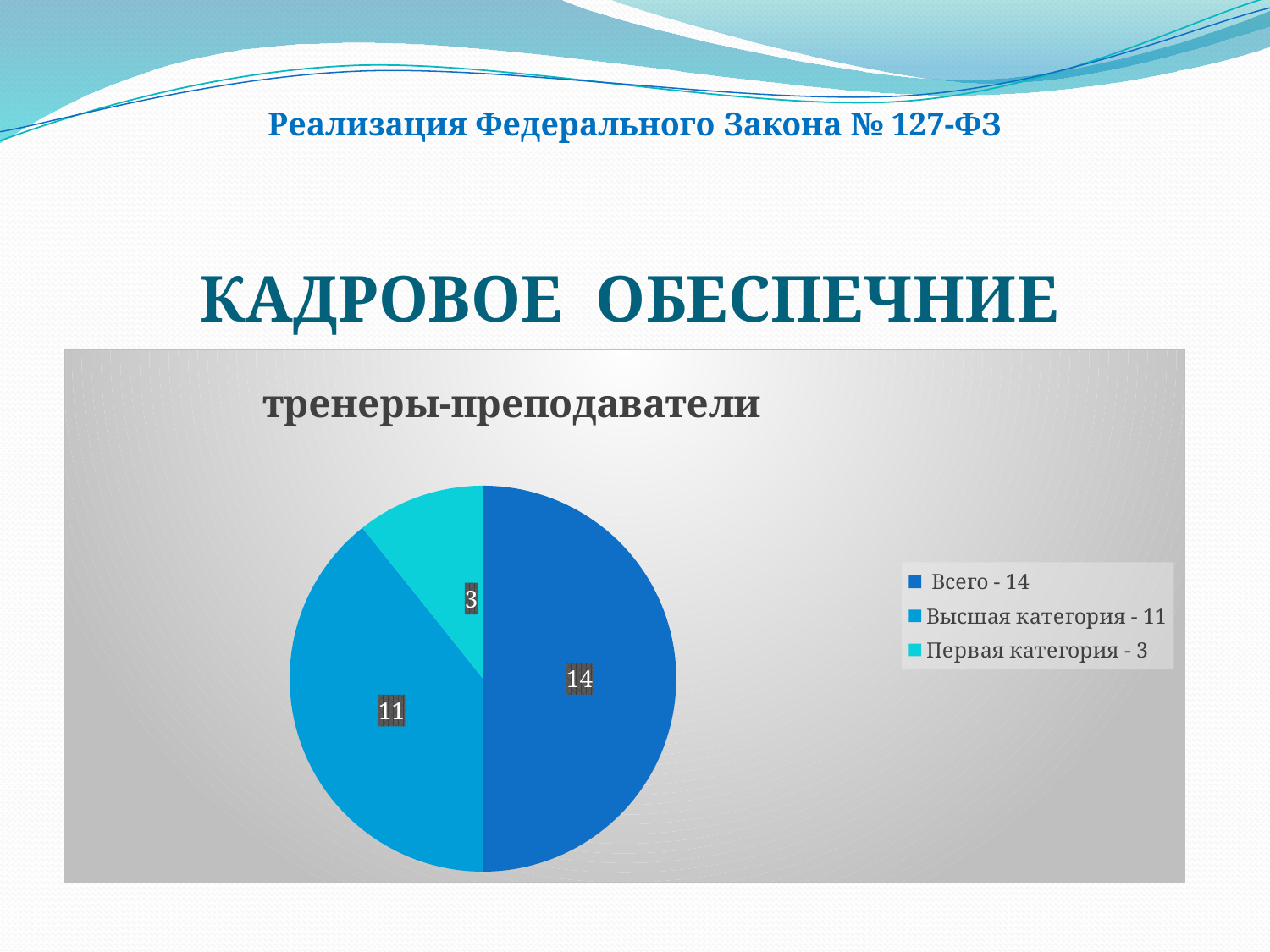
What value is shown for the slice "Первая категория - 3"? 3 What share of the pie does the slice "Всего - 14" represent? 50% What kind of chart is shown on the slide? pie chart What value is shown for the slice "Всего - 14"? 14 Which slice of the pie chart is the largest? Всего - 14 What is the title of the chart? тренеры-преподаватели How many slices does the pie chart have? 3 Which is larger, the value for "Высшая категория" or the value for "Первая категория"? Высшая категория What is the difference between the values for "Всего" and "Высшая категория"? 3 What is the difference between the values for "Высшая категория" and "Первая категория"? 8 Which slice of the pie chart is the smallest? Первая категория - 3 What value is shown for the slice "Высшая категория - 11"? 11